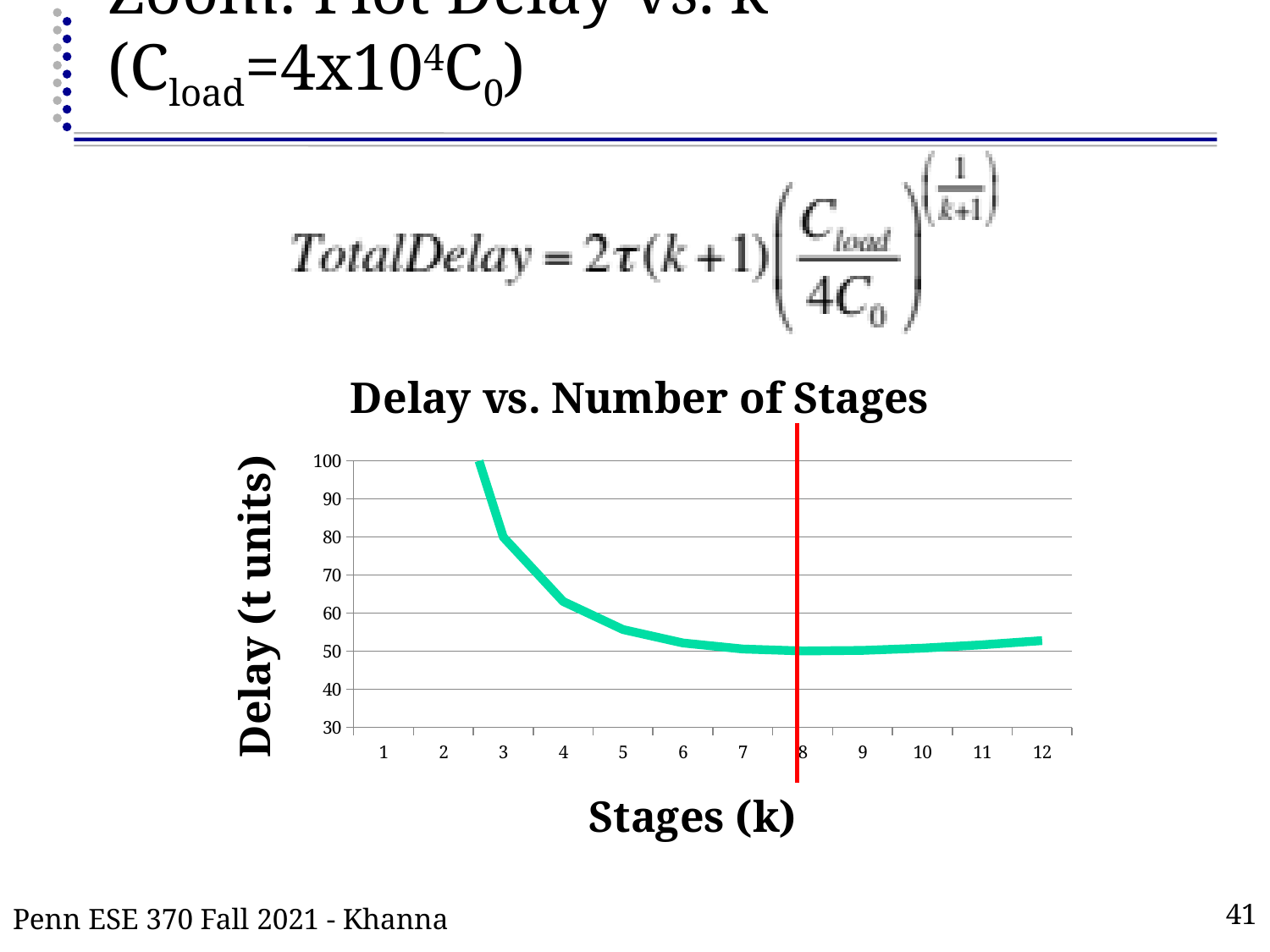
Is the delay value for k = 3 greater or less than 70? greater Is the delay value for k = 4 greater or less than 70? less How many stage values (k) are labelled along the x axis? 12 Which is larger, the delay at k = 3 or the delay at k = 6? k = 3 What is the label of the y axis of the chart? Delay (t units) Is the delay value for k = 8 greater or less than 60? less Does the delay rise or fall as k increases from 3 to 7? fall What kind of chart is shown on the slide? line chart What is the title of the chart? Delay vs. Number of Stages